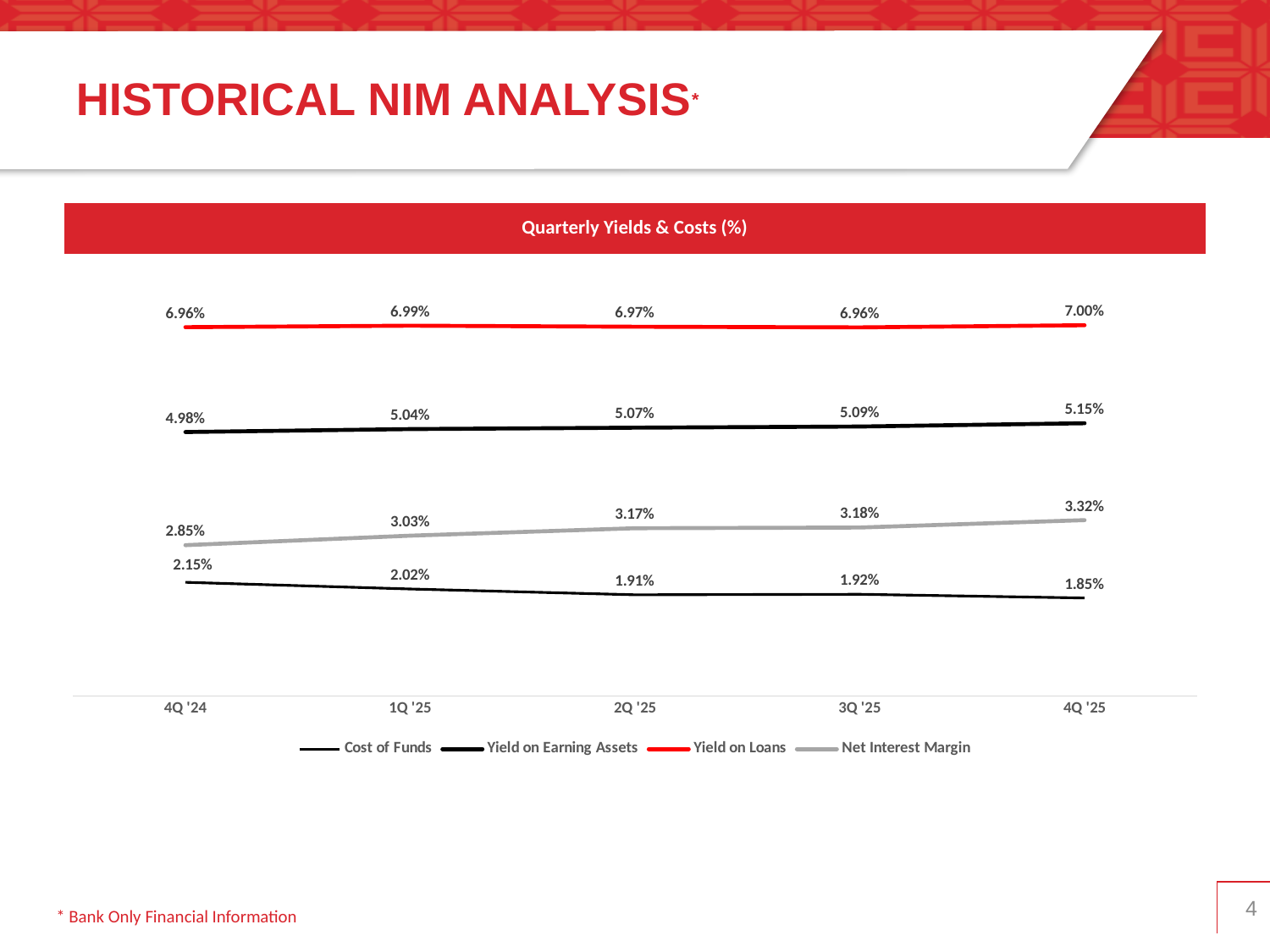
What is the Net Interest Margin value for 4Q '24? 2.85% What is the difference between the Yield on Earning Assets in 4Q '25 and 4Q '24? 0.17% What is the Yield on Loans value for 4Q '25? 7.00% How many quarters are shown on the x axis? 5 What is the Cost of Funds value for 3Q '25? 1.92% Does the Cost of Funds generally rise or fall from 4Q '24 to 4Q '25? Fall In which quarter is the Cost of Funds lowest? 4Q '25 In which quarter is the Net Interest Margin highest? 4Q '25 What is the title of the chart? Quarterly Yields & Costs (%) What is the Yield on Earning Assets value for 2Q '25? 5.07% How many series does the legend list? 4 What kind of chart is shown on the slide? Line chart